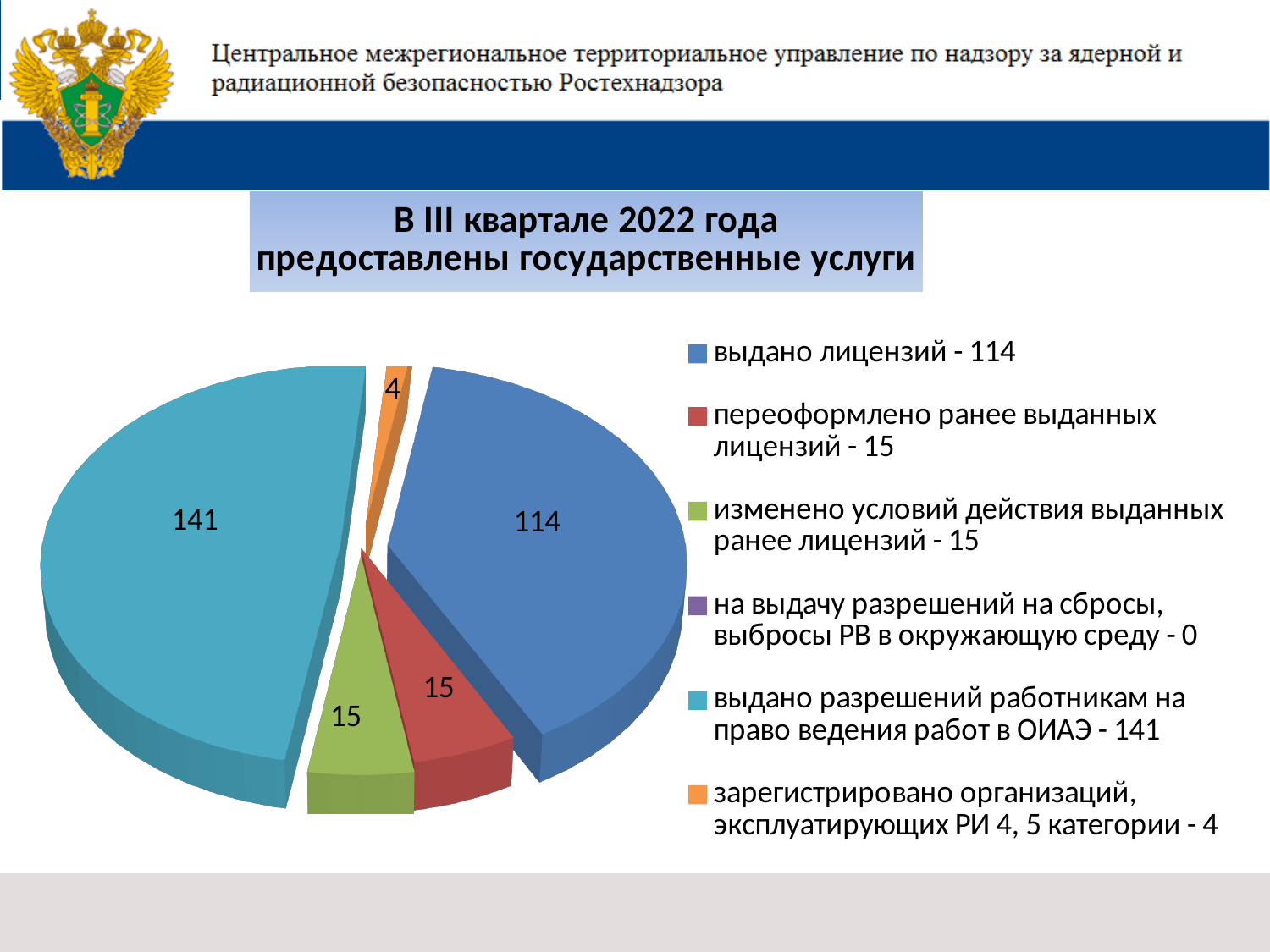
What is the value for "зарегистрировано организаций, эксплуатирующих РИ 4, 5 категории"? 4 Which is larger: the value for "выдано лицензий" or the value for "переоформлено ранее выданных лицензий"? выдано лицензий What is the value for "выдано разрешений работникам на право ведения работ в ОИАЭ"? 141 What is the total of all values shown in the chart? 289 How many categories does the legend list? 6 What is the difference between the value for "выдано разрешений работникам на право ведения работ в ОИАЭ" and the value for "выдано лицензий"? 27 What kind of chart is shown on the slide? Pie chart What is the value for "на выдачу разрешений на сбросы, выбросы РВ в окружающую среду"? 0 Which category has the smallest non-zero slice of the pie? зарегистрировано организаций, эксплуатирующих РИ 4, 5 категории - 4 What is the value for "выдано лицензий"? 114 Which category has the largest slice of the pie? выдано разрешений работникам на право ведения работ в ОИАЭ - 141 What colour is the slice for "выдано лицензий"? Blue